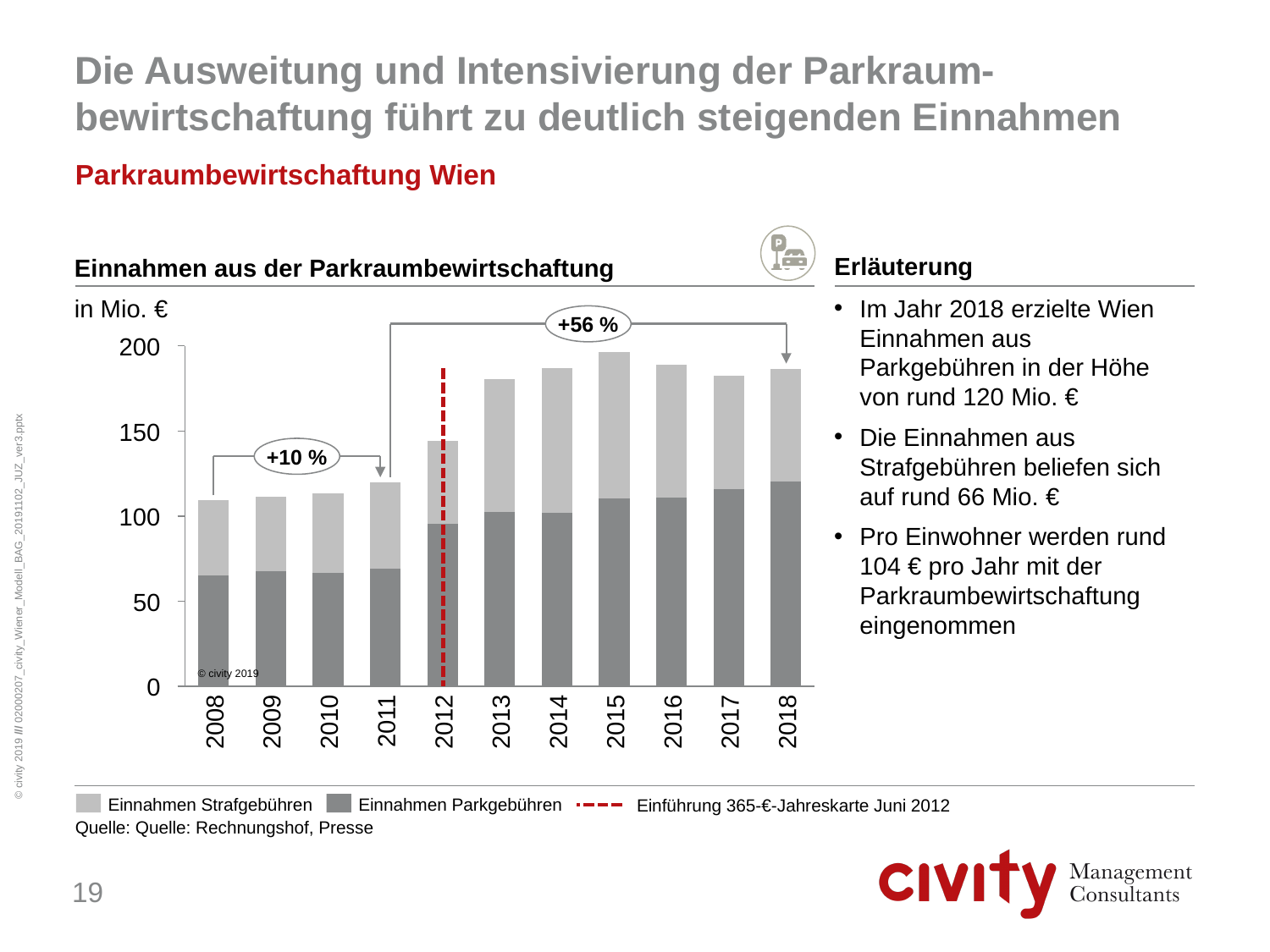
Is the total bar for 2012 greater or less than 150? less How many bar series (shaded categories) does the legend list for the chart? 2 Is the Einnahmen Parkgebühren segment for 2018 greater or less than 100? greater Which year has the larger total bar, 2011 or 2018? 2018 Do the total bars rise or fall from 2008 to 2015? rise What kind of chart is shown under 'Einnahmen aus der Parkraumbewirtschaftung'? bar chart How many years are shown on the x axis of the chart? 11 Is the Einnahmen Parkgebühren segment for 2008 greater or less than 50? greater What percentage change is annotated between 2011 and 2018 in the chart? +56 % Which year has the highest total bar in the chart? 2015